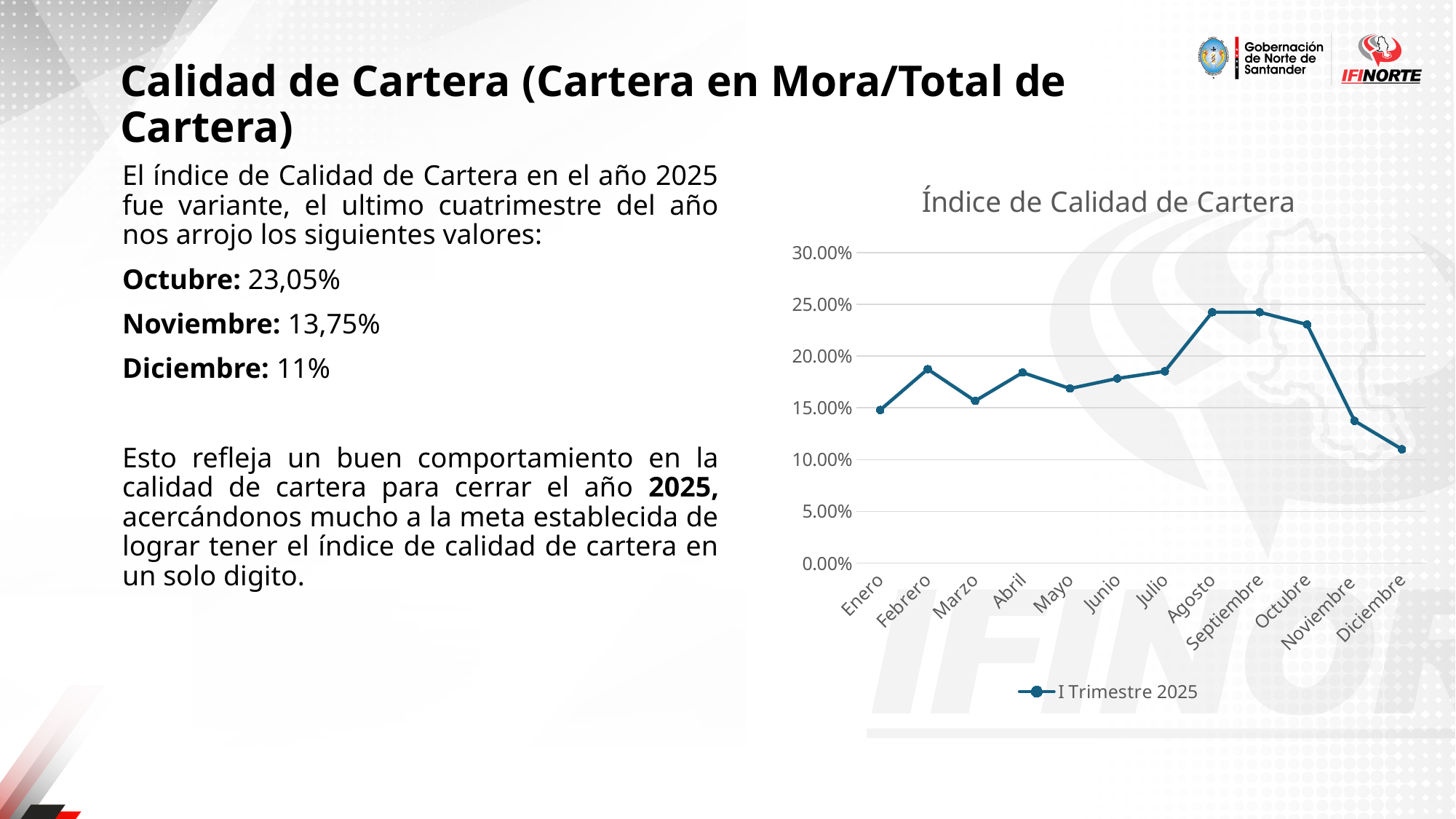
Which month has the higher value, Febrero or Marzo? Febrero How many months are plotted on the x axis of the chart? 12 How many series does the chart legend list? 1 What is the value of the Índice de Calidad de Cartera for Octubre? 23,05% What is the title of the chart? Índice de Calidad de Cartera What is the value of the Índice de Calidad de Cartera for Noviembre? 13,75% What is the value of the Índice de Calidad de Cartera for Diciembre? 11% Does the index rise or fall from Septiembre to Diciembre? Fall What type of chart is shown on the slide? Line chart Is the value for Agosto greater or less than 20.00%? greater Which month has the lowest value in the chart? Diciembre What is the name of the series shown in the chart legend? I Trimestre 2025